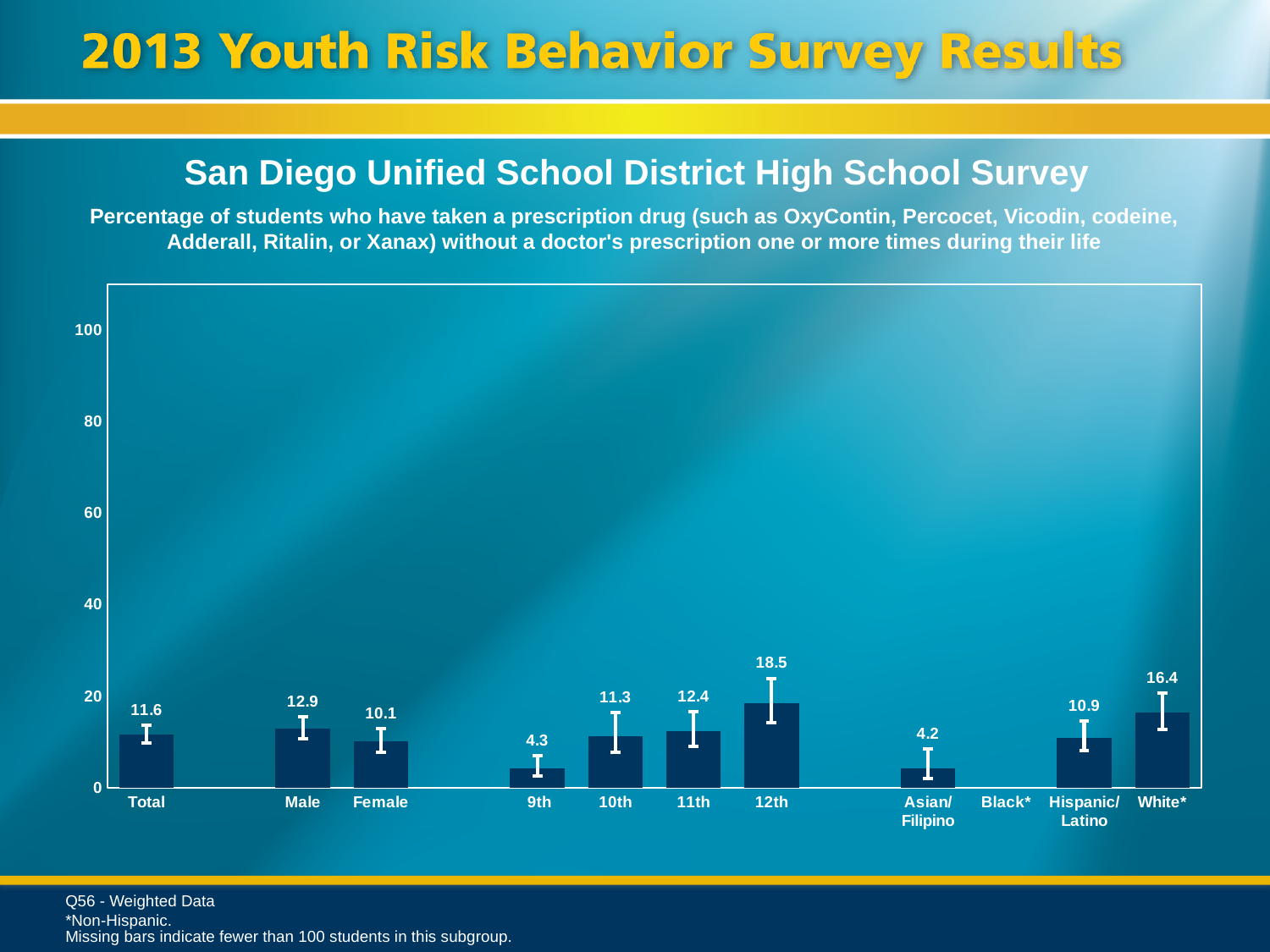
Which category has no bar plotted? Black* Which category with a plotted bar has the lowest value? Asian/Filipino What is the value for Total? 11.6 Which is larger, the value for 10th or the value for 11th? 11th What is the value for 12th grade? 18.5 Is the value for White* greater or less than 20? less How many categories are labelled on the x axis? 11 What is the difference between the Male and Female values? 2.8 What kind of chart is shown? bar chart Do the values rise or fall from 9th to 12th grade? rise Which category has the highest value? 12th What is the value for Asian/Filipino? 4.2